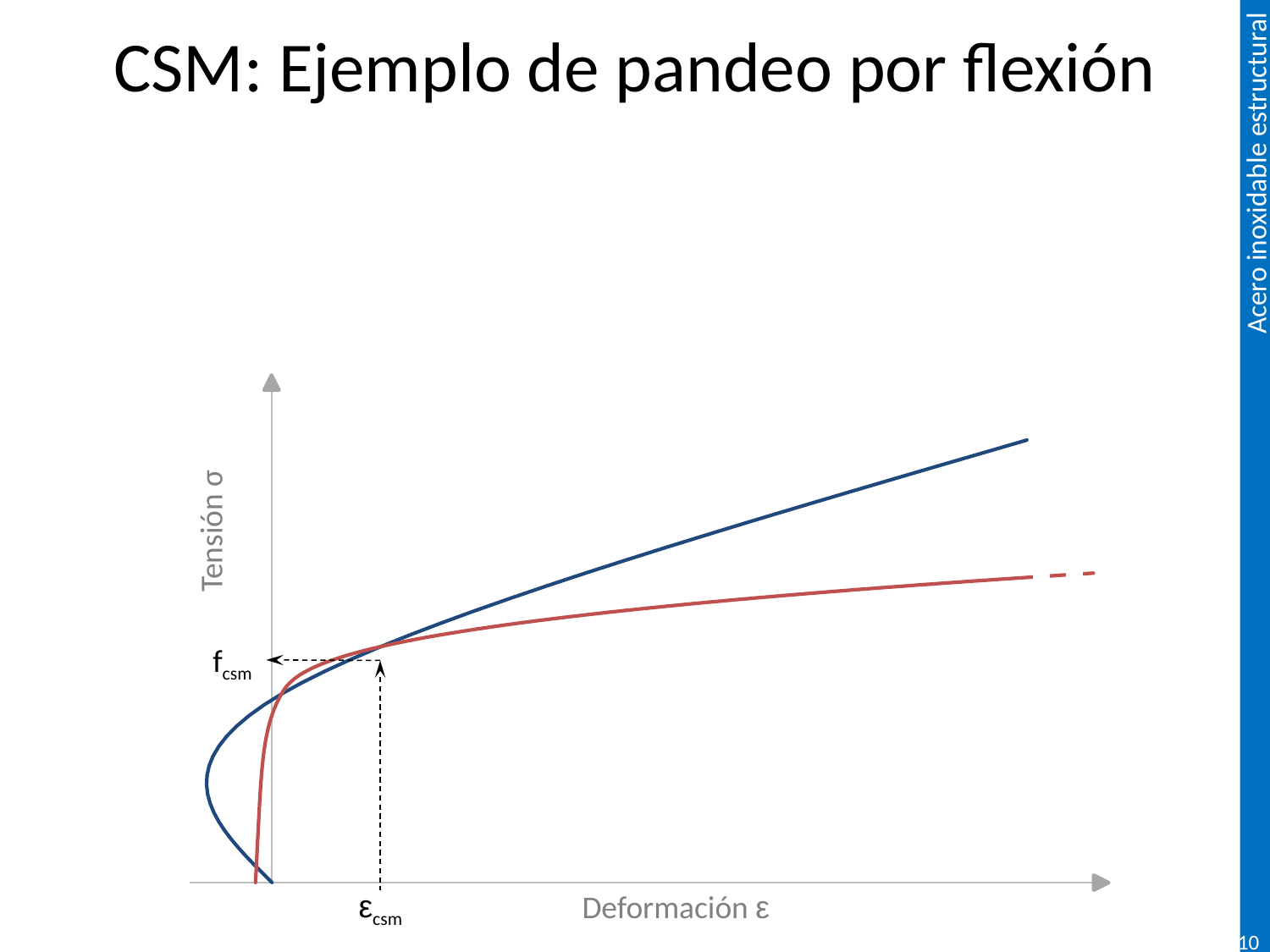
Does the red curve rise or fall as deformation increases along the x axis? rise What kind of chart is shown on the slide? line chart How many curves are plotted on the chart? 2 What label marks the strain value indicated by the dashed vertical line on the x axis? εcsm What label marks the stress value indicated by the dashed horizontal line on the y axis? fcsm At the right end of the chart, which curve is higher, the blue one or the red one? the blue one What is the label of the vertical axis of the chart? Tensión σ What is the label of the horizontal axis of the chart? Deformación ε